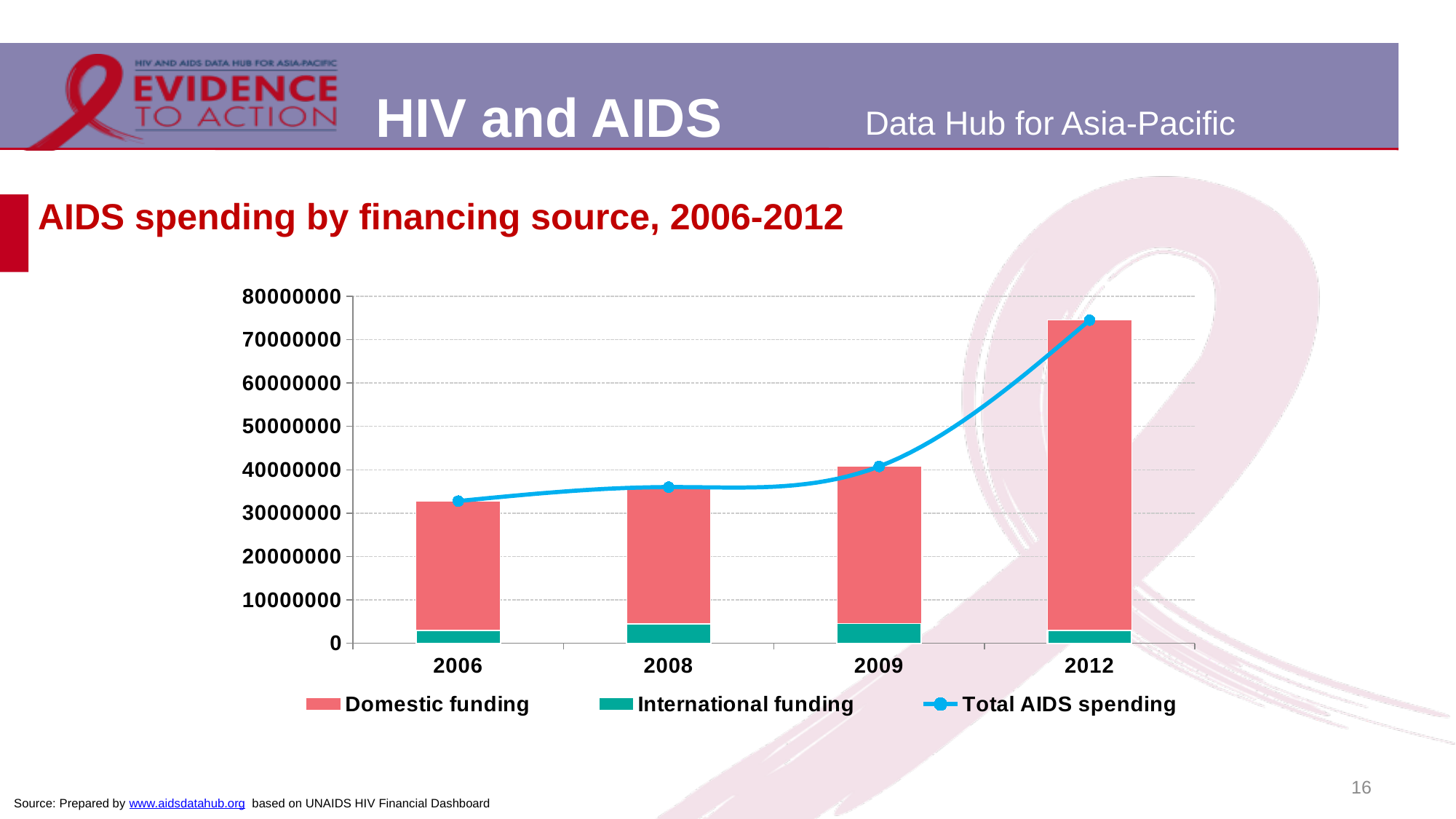
Which is larger, the Total AIDS spending in 2012 or in 2009? 2012 Which year has the highest Total AIDS spending? 2012 Does Total AIDS spending rise or fall from 2006 to 2012? rise What is the title of the chart? AIDS spending by financing source, 2006-2012 How many series does the legend list? 3 What kind of chart is used for the Domestic funding and International funding series? bar chart Is the Total AIDS spending for 2012 greater or less than 70000000? greater Which series is shown as a line with markers? Total AIDS spending Is the Total AIDS spending for 2009 greater or less than 50000000? less Is the Total AIDS spending for 2008 greater or less than 40000000? less Which year has the lowest Total AIDS spending? 2006 How many years are shown on the x axis? 4